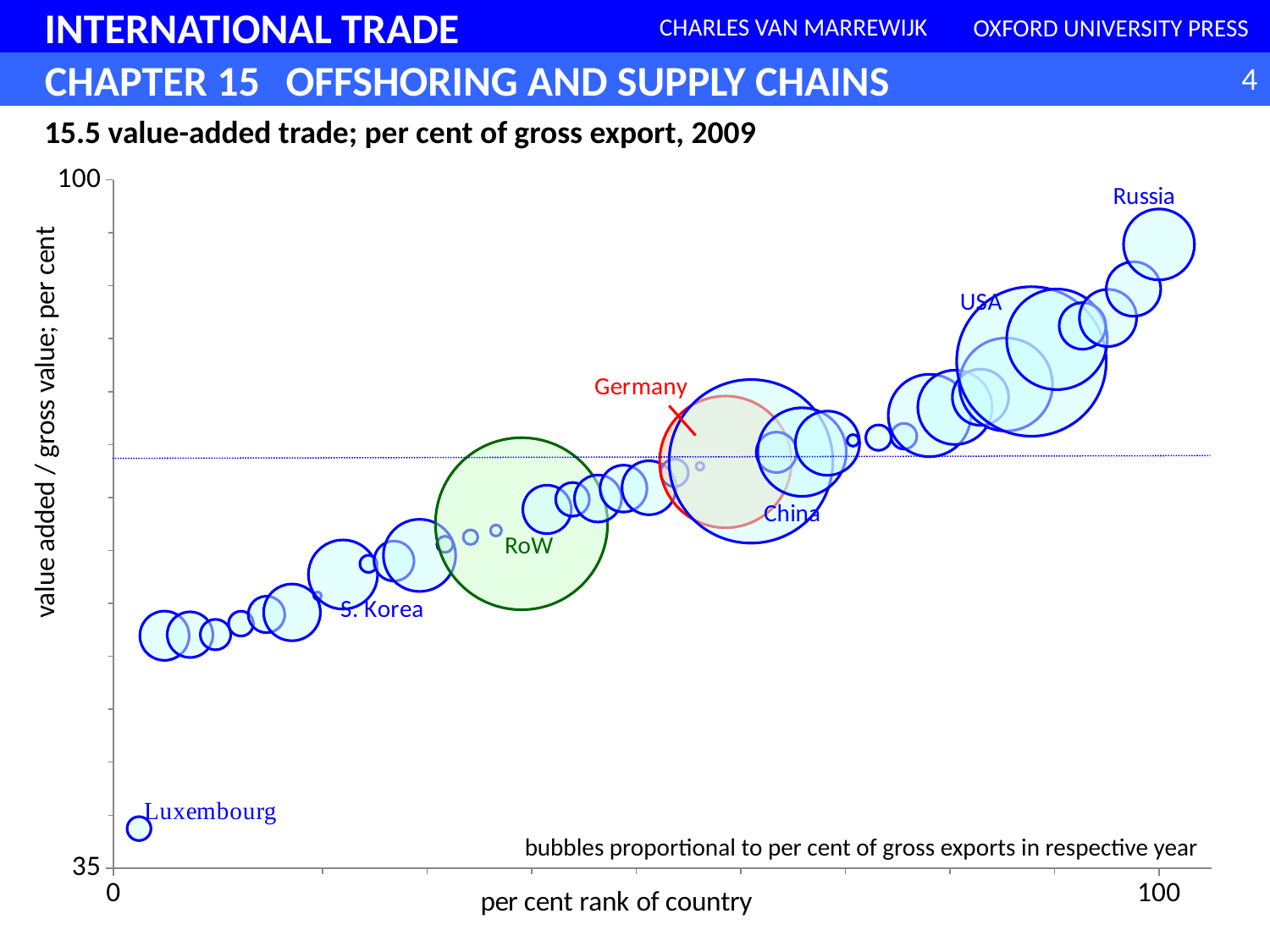
What is the lowest value shown on the vertical axis? 35 Which labelled country has the lowest value added as a share of gross value? Luxembourg What is the label of the vertical axis? value added / gross value; per cent Which labelled country has the highest value added as a share of gross value? Russia Which has a higher value added share: USA or China? USA Do the values generally rise or fall as the per cent rank of country increases along the x axis? rise How many countries or groups are labelled by name on the chart? 7 Which has a higher value added share: Russia or S. Korea? Russia What is the title of the chart? 15.5 value-added trade; per cent of gross export, 2009 What kind of chart is shown on the slide? bubble chart Which has a higher value added share: Germany or Luxembourg? Germany Is the value added share for Russia greater or less than 100? less